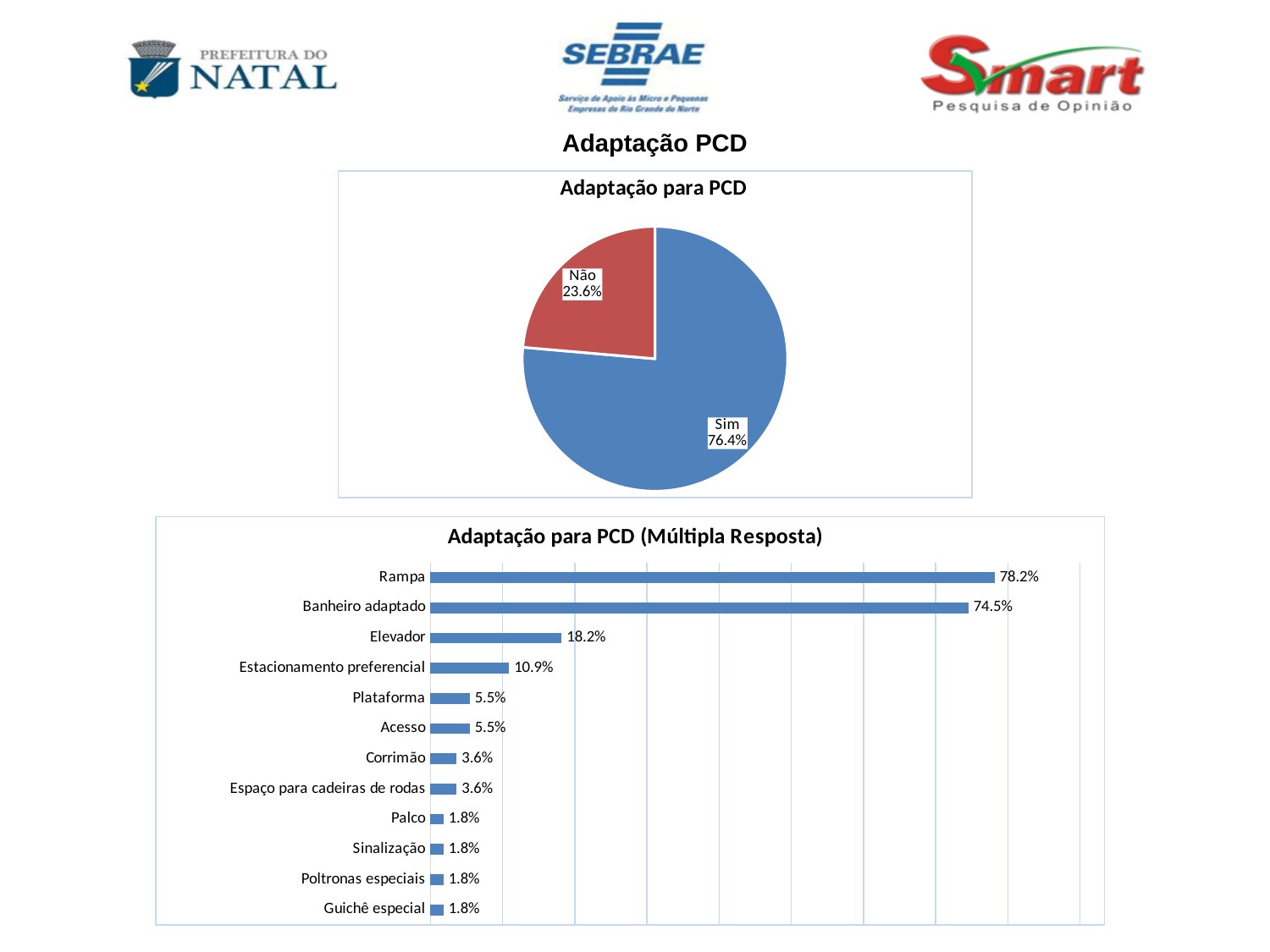
In the 'Adaptação para PCD' pie chart, what share is labelled 'Não'? 23.6% In 'Adaptação para PCD (Múltipla Resposta)', what is the value for 'Banheiro adaptado'? 74.5% In 'Adaptação para PCD (Múltipla Resposta)', which is larger, 'Elevador' or 'Plataforma'? Elevador In the 'Adaptação para PCD' pie chart, which slice is larger, 'Sim' or 'Não'? Sim In 'Adaptação para PCD (Múltipla Resposta)', what is the value for 'Rampa'? 78.2% In 'Adaptação para PCD (Múltipla Resposta)', how many categories are shown? 12 What kind of chart is the 'Adaptação para PCD' chart at the top of the slide? Pie chart In 'Adaptação para PCD (Múltipla Resposta)', what is the difference between 'Rampa' and 'Elevador'? 60.0% In the 'Adaptação para PCD' pie chart, what share is labelled 'Sim'? 76.4% In 'Adaptação para PCD (Múltipla Resposta)', which category has the highest value? Rampa What kind of chart is 'Adaptação para PCD (Múltipla Resposta)'? Bar chart In 'Adaptação para PCD (Múltipla Resposta)', what is the value for 'Estacionamento preferencial'? 10.9%